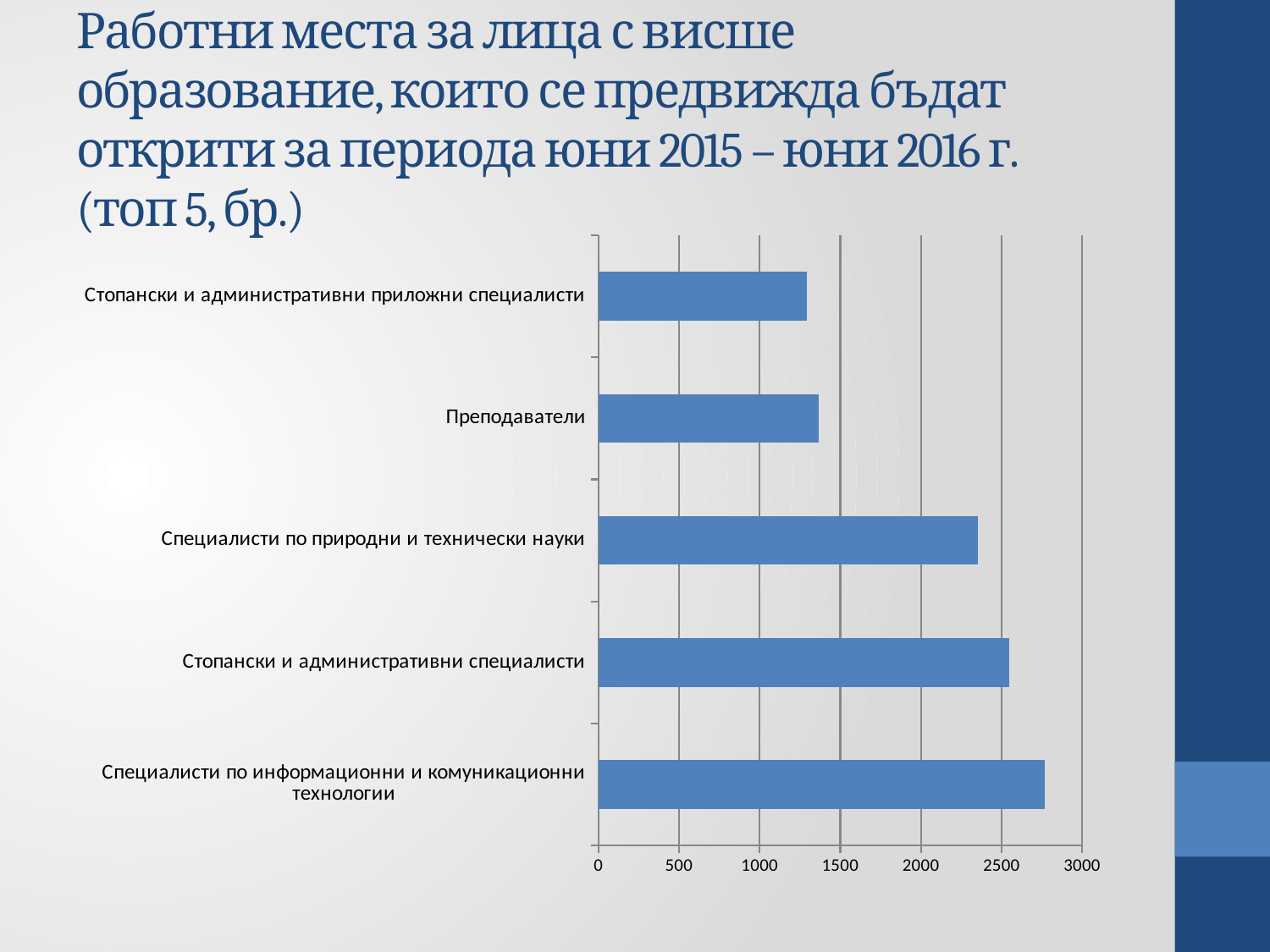
What is the maximum value shown on the horizontal axis of the chart? 3000 Is the value for Специалисти по природни и технически науки greater or less than 2500? less Which is larger: the value for Специалисти по информационни и комуникационни технологии or the value for Стопански и административни специалисти? Специалисти по информационни и комуникационни технологии Which category has the highest value in the chart? Специалисти по информационни и комуникационни технологии Is the value for Преподаватели greater or less than 1500? less Is the value for Стопански и административни специалисти greater or less than 2000? greater How many categories are shown in the chart? 5 Which is larger: the value for Преподаватели or the value for Специалисти по природни и технически науки? Специалисти по природни и технически науки What kind of chart is shown on the slide? bar chart